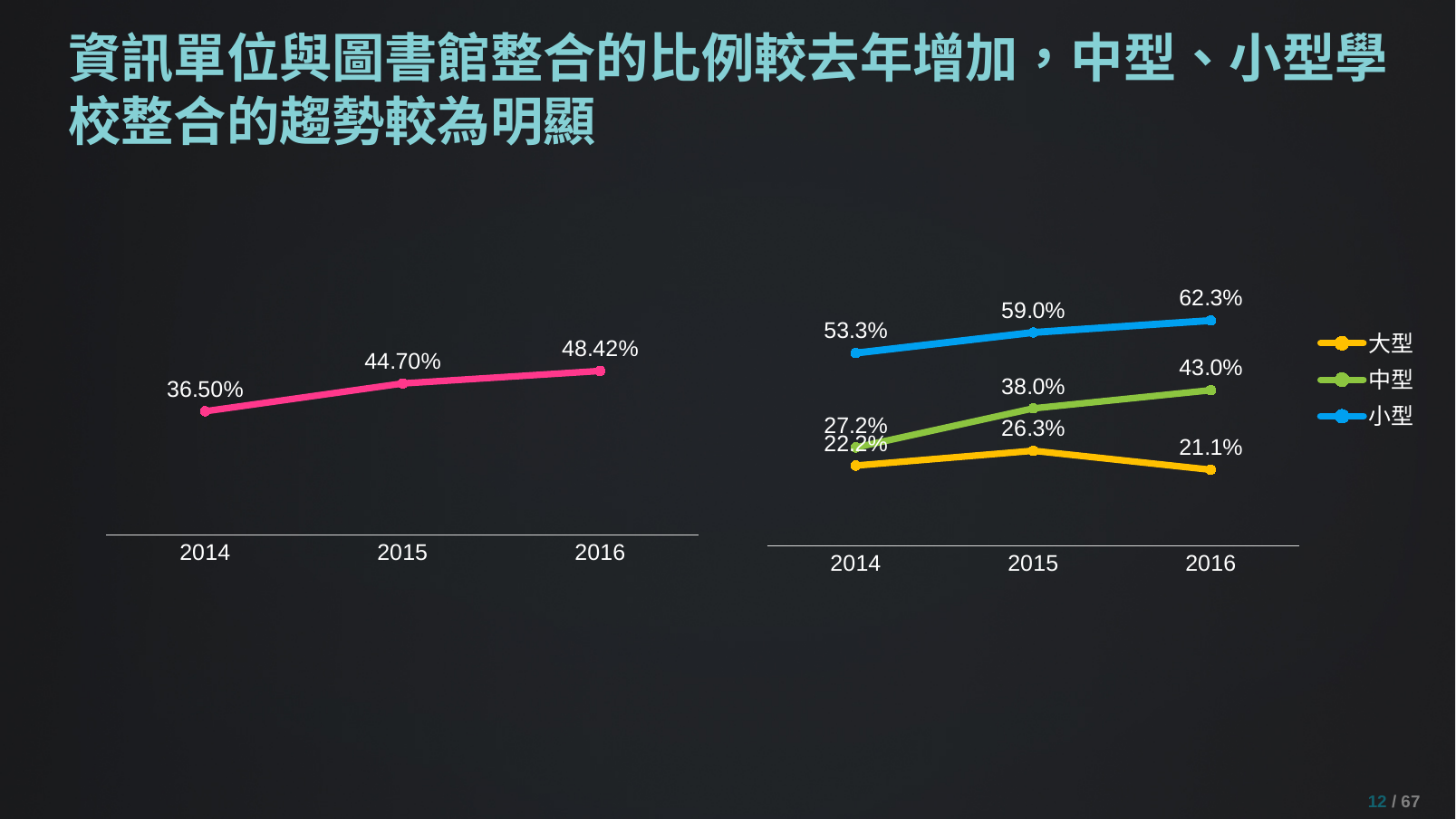
In the right chart, what is the difference between 小型 and 中型 in 2016? 19.3% What kind of chart is the left chart? line chart In the right chart, what is the value for 中型 in 2015? 38.0% In the right chart, what is the value for 大型 in 2016? 21.1% In the left chart, what is the value for 2014? 36.50% How many series does the legend of the right chart list? 3 In the right chart, which series has the lowest value in 2016? 大型 In the left chart, which year has the highest value? 2016 In the left chart, what is the value for 2016? 48.42% In the left chart, do the values rise or fall from 2014 to 2016? rise In the left chart, what is the difference between the 2015 and 2014 values? 8.20% In the right chart, what is the value for 小型 in 2016? 62.3%